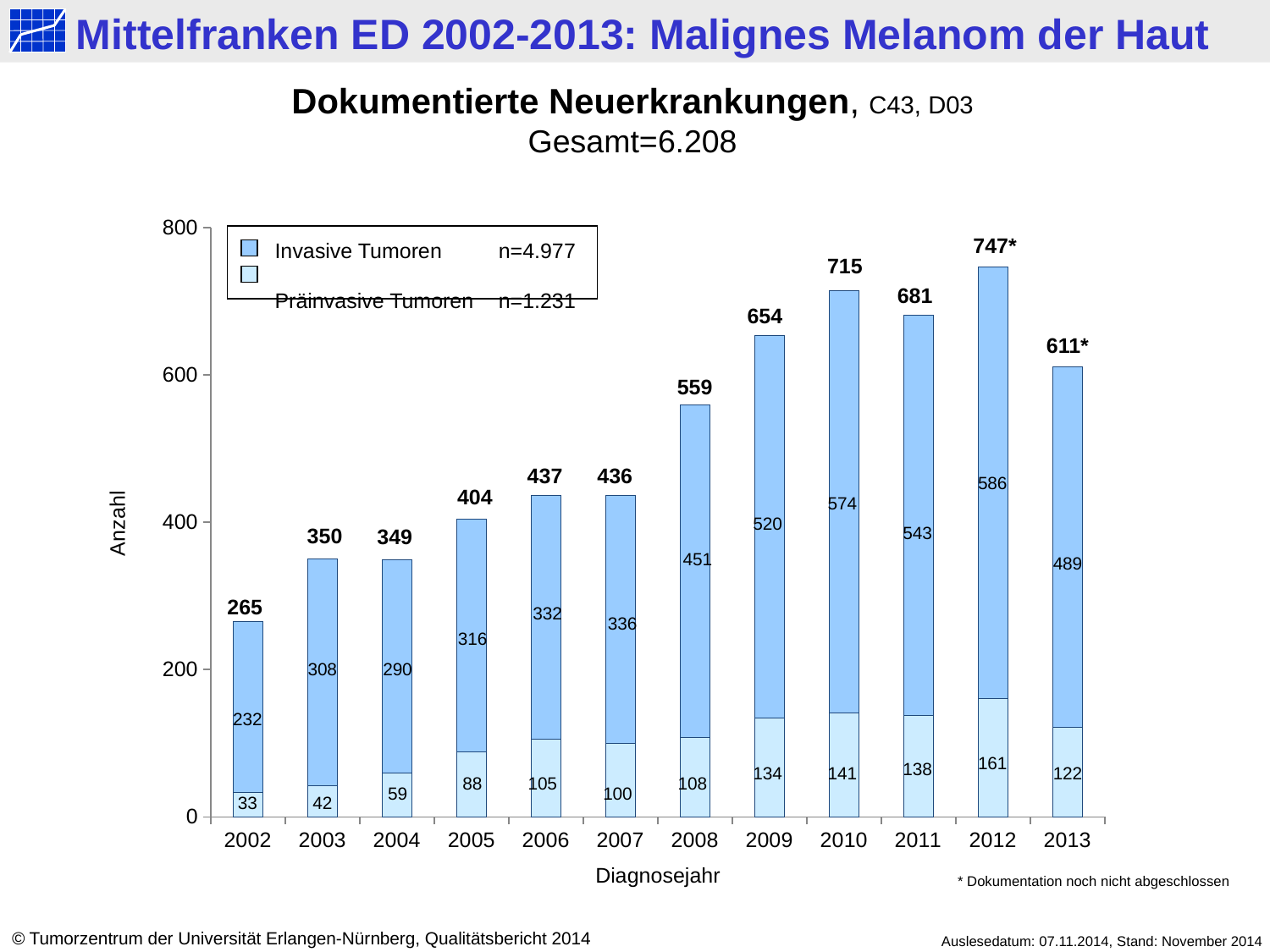
Is the total for 2006 greater or less than 400? greater Which year has the lowest number of Präinvasive Tumoren? 2002 Which is larger: the number of Invasive Tumoren in 2011 or in 2013? 2011 What is the number of Invasive Tumoren in 2009? 520 How many diagnosis years are shown on the x axis? 12 How many series does the legend list? 2 What is the label of the y axis? Anzahl What kind of chart is shown on the slide? Stacked bar chart Which year has the highest total number of documented new cases? 2012 What is the total height of the stacked bar for 2007? 436 What is the difference between the total for 2010 and the total for 2008? 156 What is the number of Präinvasive Tumoren in 2005? 88